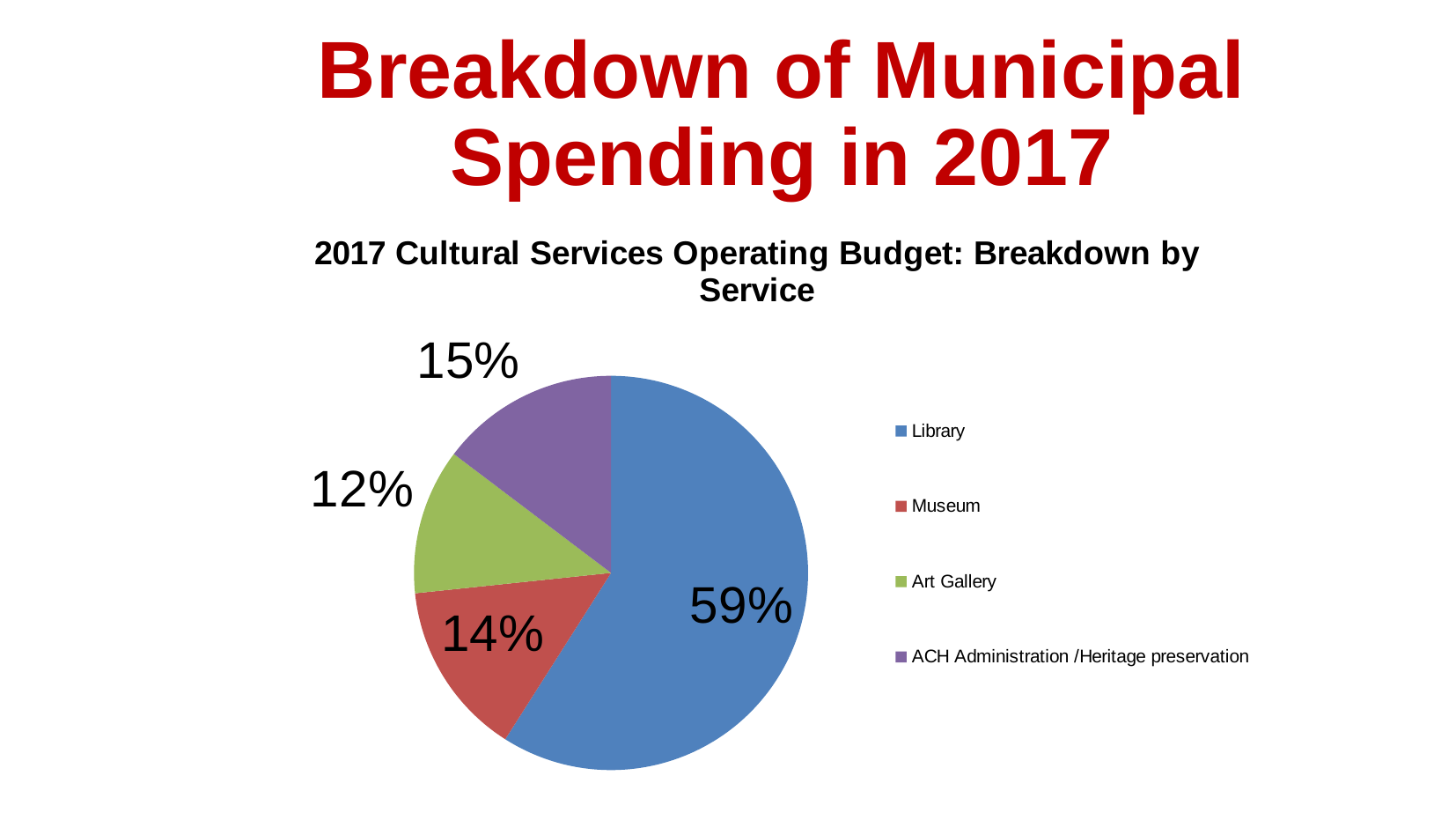
How many slices does the pie chart have? 4 Which has a larger share, the Museum or the Art Gallery? Museum How many percentage points larger is the Library's share than the Museum's share? 45 What share of the budget goes to ACH Administration /Heritage preservation? 15% What is the title of the chart? 2017 Cultural Services Operating Budget: Breakdown by Service Which service has the smallest share of the budget? Art Gallery Which service has the largest share of the budget? Library What share of the budget goes to the Art Gallery? 12% What kind of chart is shown on the slide? pie chart How many entries does the legend list? 4 What share of the 2017 Cultural Services Operating Budget goes to the Library? 59%